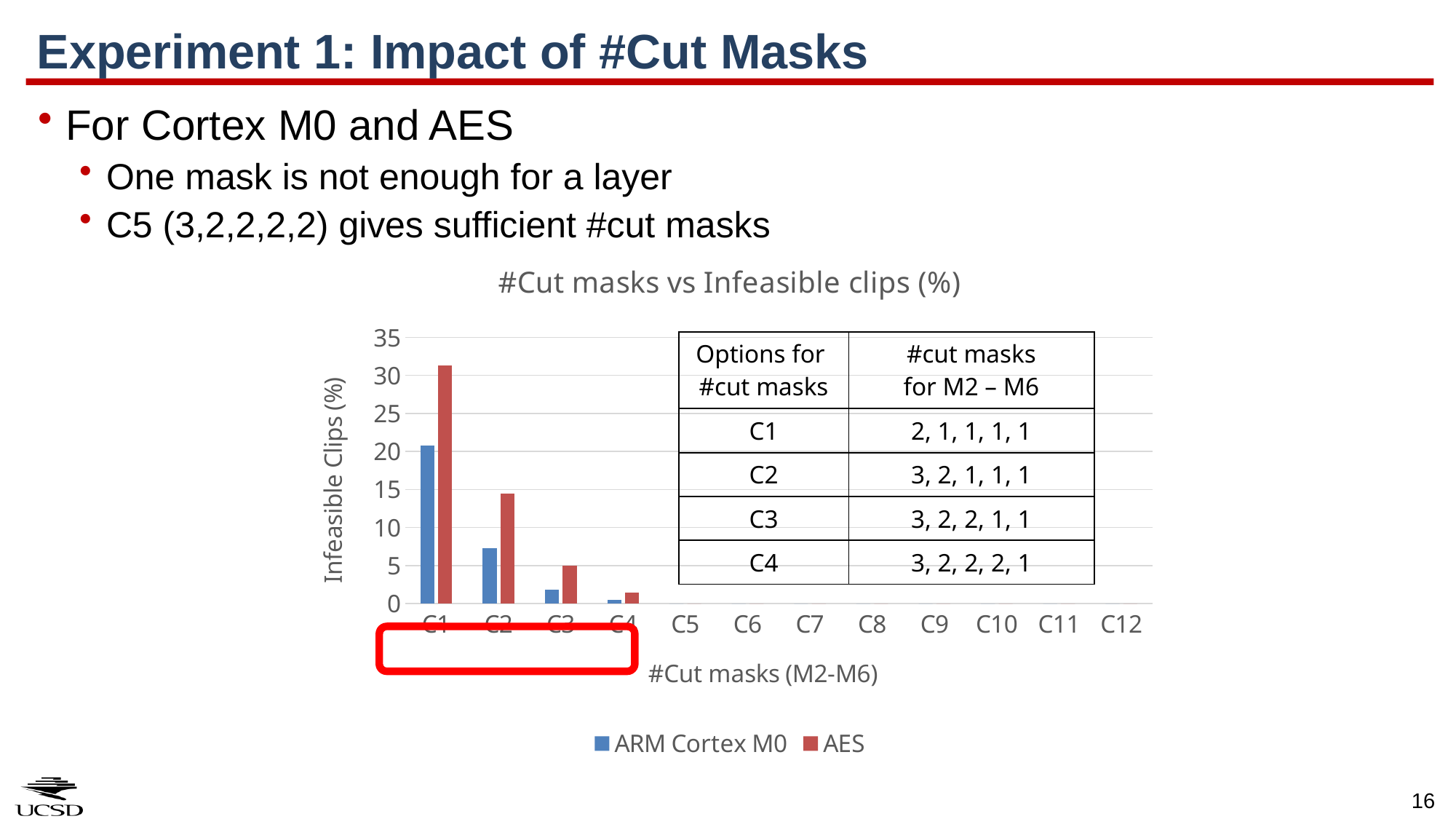
Is the ARM Cortex M0 value for C1 greater or less than 15? greater At C2, which series has the larger value, ARM Cortex M0 or AES? AES Which category has the highest AES value? C1 How many categories are shown on the x axis of the chart? 12 What is the title of the chart? #Cut masks vs Infeasible clips (%) Do the AES values rise or fall from C1 to C4? fall Is the AES value for C1 greater or less than 25? greater How many series does the chart legend list? 2 Is the AES value for C2 greater or less than 10? greater What kind of chart is shown on the slide? bar chart At C1, which series has the larger value, ARM Cortex M0 or AES? AES Which category has the highest ARM Cortex M0 value? C1